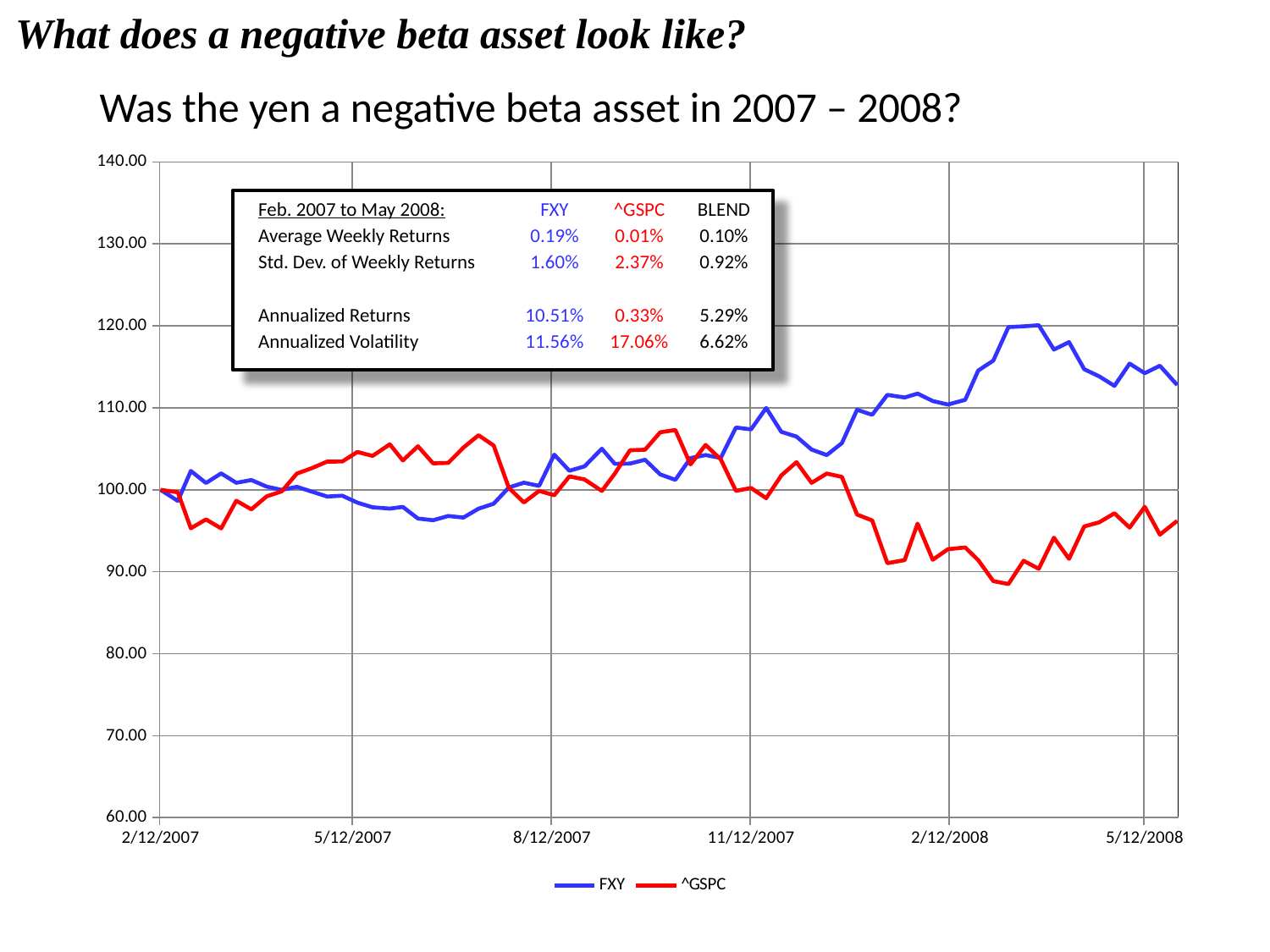
At 5/12/2008, which series has the higher value, FXY or ^GSPC? FXY Which series is drawn in red on the chart? ^GSPC What are the two series named in the chart's legend? FXY and ^GSPC Is the value for FXY at 5/12/2008 greater or less than 110? greater Between 11/12/2007 and 2/12/2008, does the ^GSPC line rise or fall? fall Is the value for ^GSPC at 5/12/2008 greater or less than 100? less How many date labels are shown on the chart's x axis? 6 How many series does the chart's legend list? 2 Is the value for FXY at 2/12/2008 greater or less than 100? greater Between 11/12/2007 and 2/12/2008, does the FXY line rise or fall? rise What kind of chart is shown on the slide? line chart